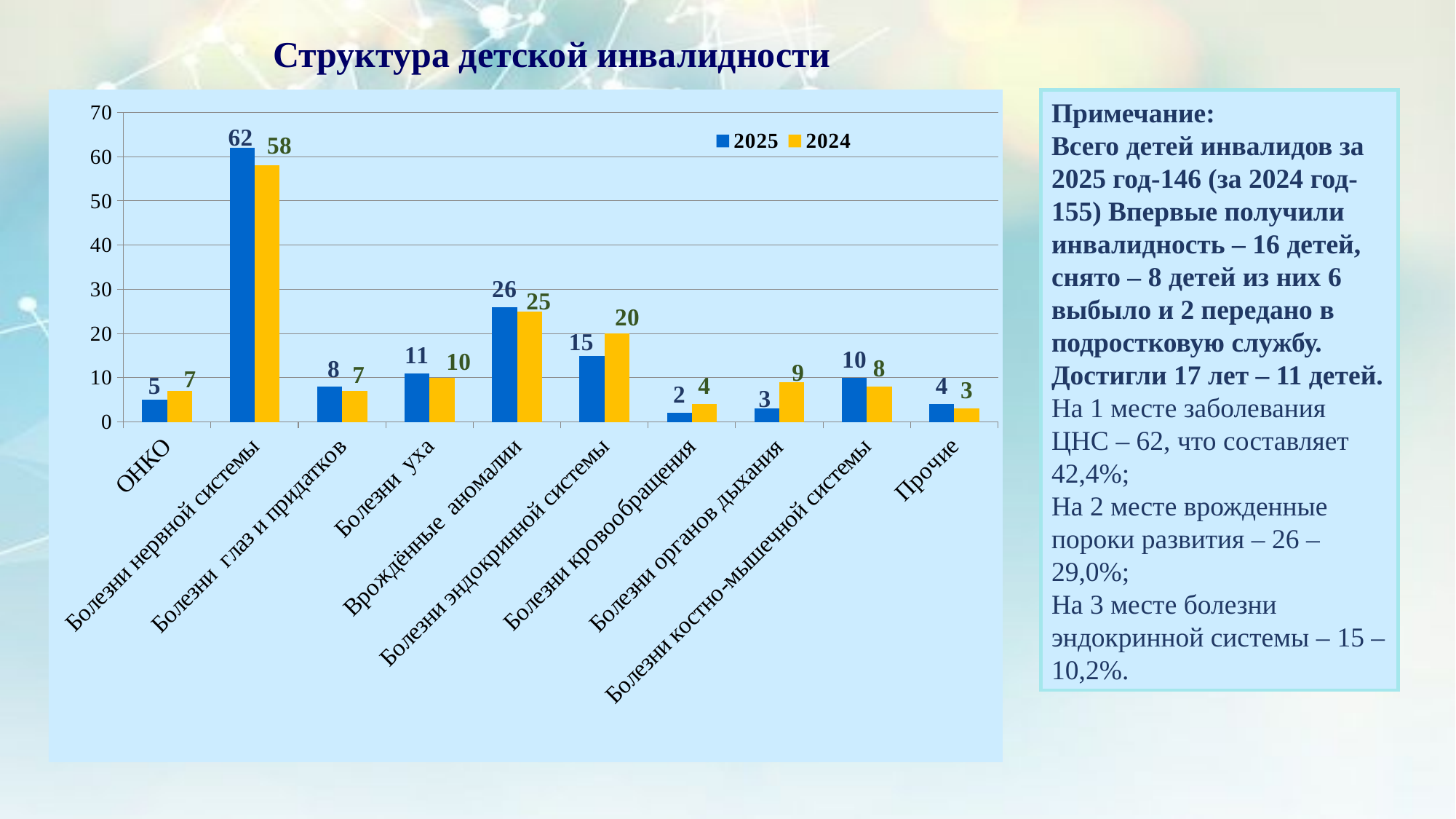
Which category has the lowest 2025 value? Болезни кровообращения What is the 2024 value for Болезни эндокринной системы? 20 How many categories are shown on the x axis? 10 What is the difference between the 2025 and 2024 values for Болезни нервной системы? 4 Is the 2025 value for Врождённые аномалии greater or less than 20? greater Which is larger for Болезни органов дыхания: the 2025 value or the 2024 value? 2024 What is the title of the slide? Структура детской инвалидности What is the 2025 value for Болезни нервной системы? 62 Which category has the highest 2025 value? Болезни нервной системы How many series does the legend list? 2 What kind of chart is shown on the slide? bar chart What is the 2024 value for ОНКО? 7